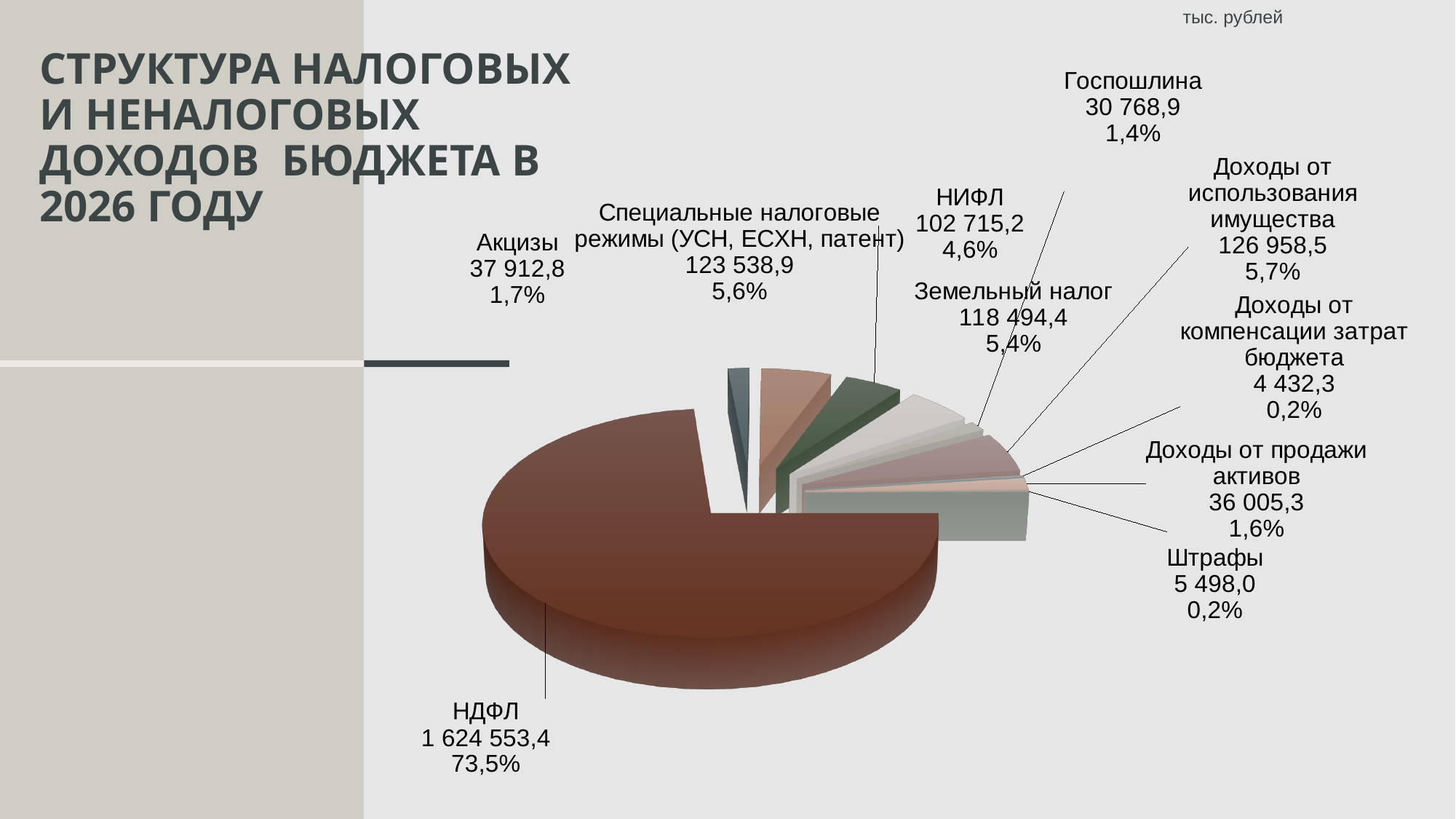
Which category has the smallest value? Доходы от компенсации затрат бюджета Which category has the largest value? НДФЛ What kind of chart is shown on the slide? Pie chart What is the difference between Земельный налог and НИФЛ? 15 779,2 How many categories are shown in the pie chart? 10 What is the value for НДФЛ? 1 624 553,4 What share of the pie does Госпошлина represent? 1,4% What is the value for Земельный налог? 118 494,4 In what units are the values on the chart given? тыс. рублей What is the difference between Доходы от использования имущества and Специальные налоговые режимы (УСН, ЕСХН, патент)? 3 419,6 Which is larger, Акцизы or Доходы от продажи активов? Акцизы What share of the pie does НДФЛ represent? 73,5%